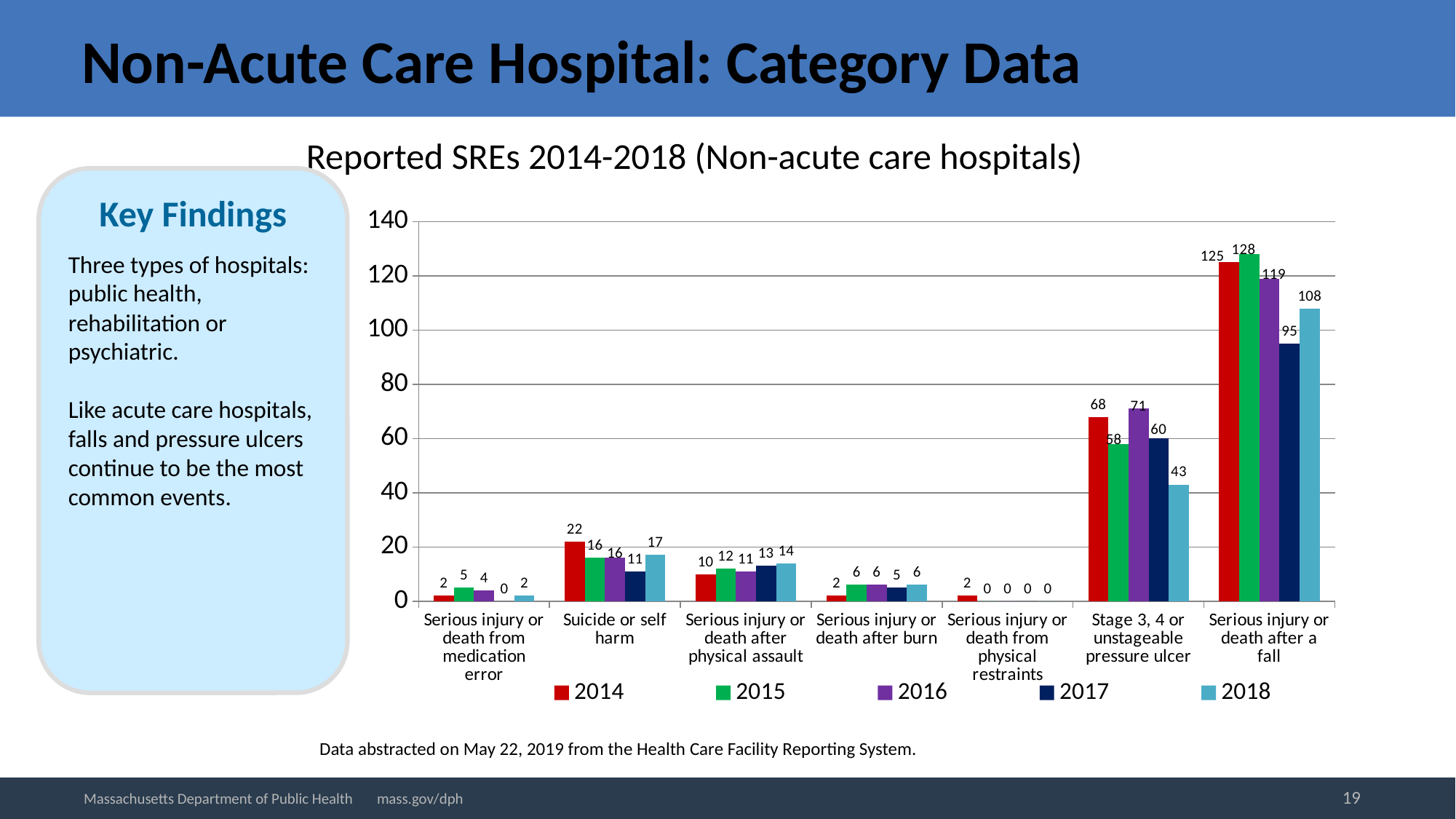
What is the difference between the 2015 and 2017 values for Serious injury or death after a fall? 33 How many series does the legend list? 5 Which category has the highest 2015 value? Serious injury or death after a fall What is the 2016 value for Stage 3, 4 or unstageable pressure ulcer? 71 What is the 2018 value for Serious injury or death after a fall? 108 How many categories are shown on the x axis? 7 What kind of chart is shown? bar chart What is the 2014 value for Suicide or self harm? 22 Is the 2017 value for Serious injury or death after a fall greater or less than 100? less Which is larger for Serious injury or death after physical assault: the 2014 value or the 2018 value? 2018 What is the title of the chart? Reported SREs 2014-2018 (Non-acute care hospitals) Which year has the lowest value for Stage 3, 4 or unstageable pressure ulcer? 2018